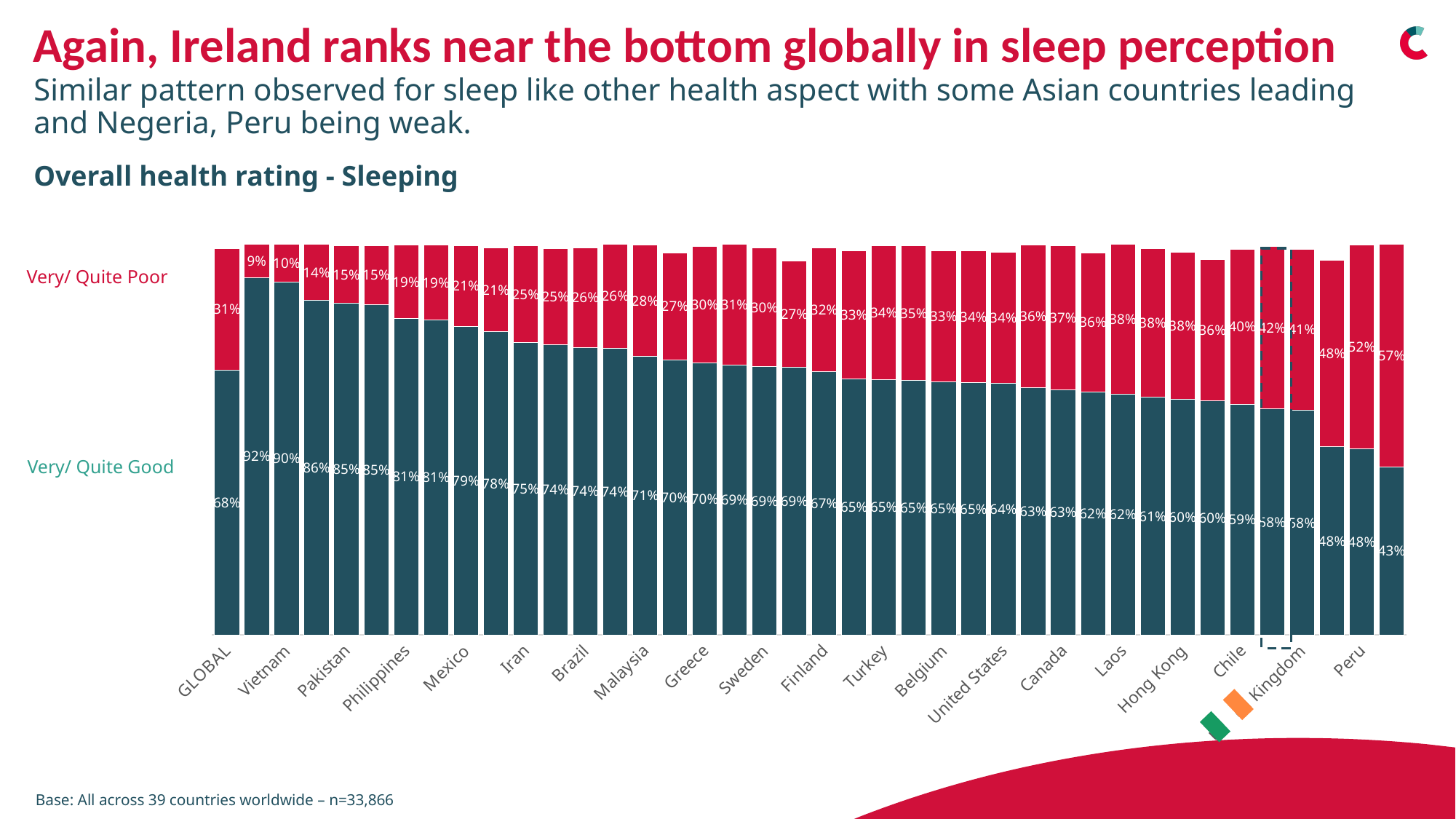
What is the lowest Very/Quite Good value shown in the chart? 43% What is the Very/Quite Poor value for GLOBAL? 31% What is the Very/Quite Good value for Peru? 48% What is the Very/Quite Good value for GLOBAL? 68% What is the Very/Quite Poor value for Peru? 52% What kind of chart is shown on the slide? Stacked bar chart What is the highest Very/Quite Good value shown in the chart? 92% How many series does the chart show? 2 Do the Very/Quite Good values rise or fall from left to right across the chart? Fall What is the title of the chart? Overall health rating - Sleeping Which has a higher Very/Quite Good value, GLOBAL or Peru? GLOBAL What is the Very/Quite Good value for the bar highlighted with a dashed outline (Ireland)? 58%